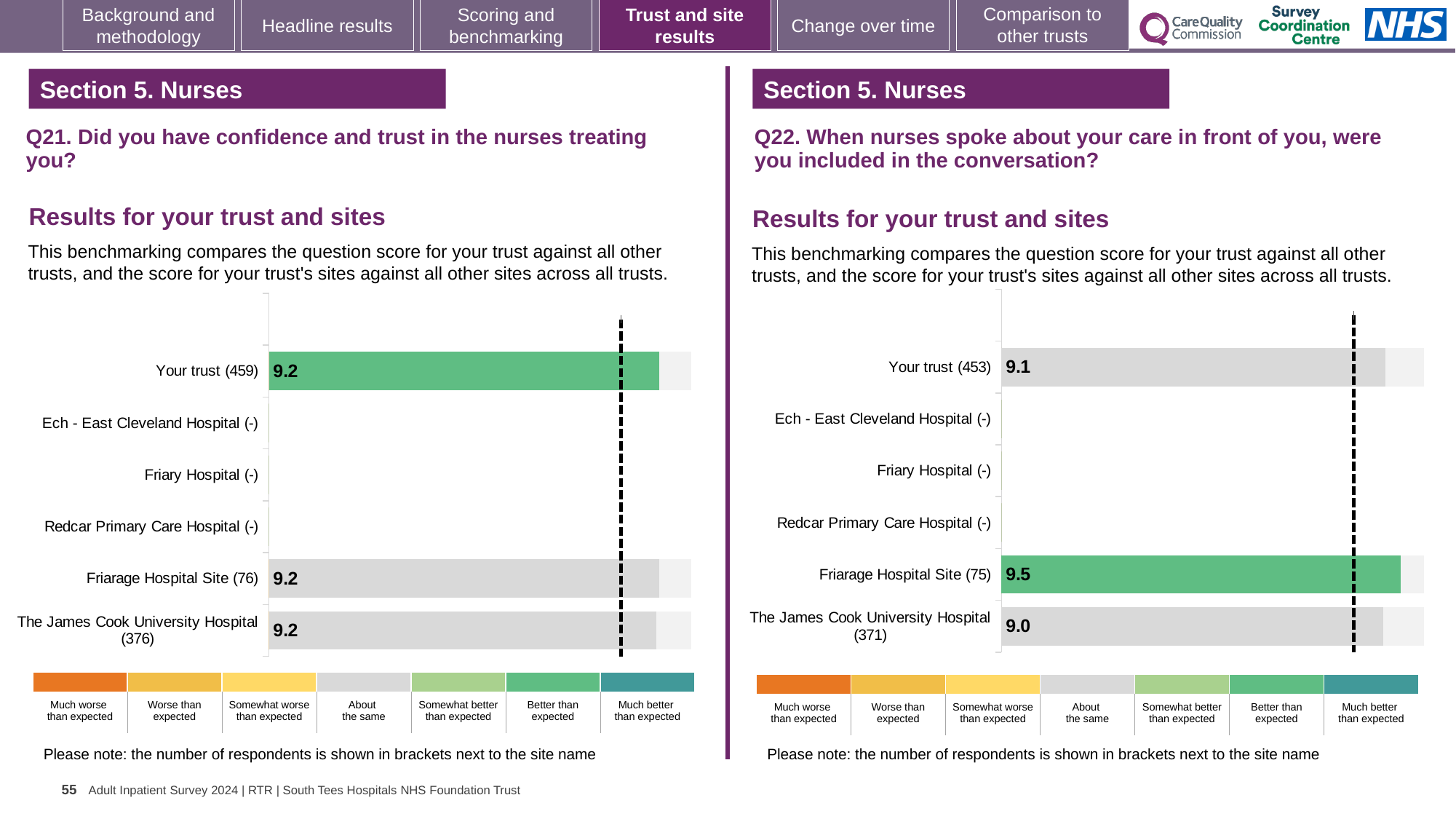
In the Q22 chart on the right, which has the larger score: Your trust (453) or Friarage Hospital Site (75)? Friarage Hospital Site (75) In the Q22 chart on the right, which site has the highest score? Friarage Hospital Site (75) How many site/trust categories are listed on the y axis of the Q21 chart on the left? 6 What type of chart is used for the Q21 results on the left? Bar chart In the Q22 chart on the right, what is the score for The James Cook University Hospital (371)? 9.0 In the Q22 chart on the right, what is the score for Your trust (453)? 9.1 In the Q22 chart on the right, what is the difference between the scores for Friarage Hospital Site (75) and The James Cook University Hospital (371)? 0.5 In the Q21 chart on the left, what is the score for Your trust (459)? 9.2 In the Q22 chart on the right, which bar is coloured green rather than grey? Friarage Hospital Site (75) In the Q22 chart on the right, what is the score for Friarage Hospital Site (75)? 9.5 In the Q21 chart on the left, what is the score for The James Cook University Hospital (376)? 9.2 In the Q22 chart on the right, which site has the lowest score? The James Cook University Hospital (371)